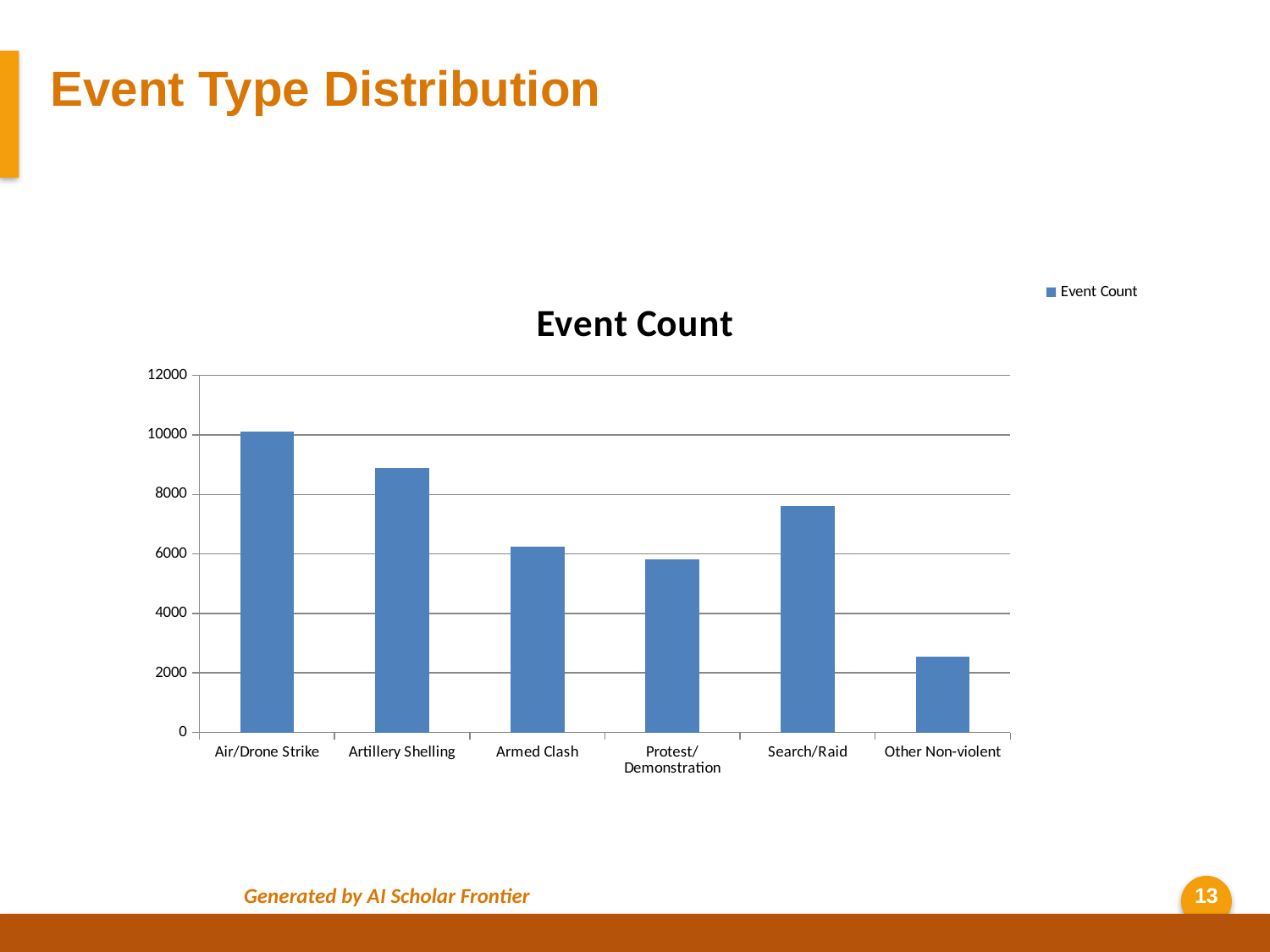
Is the event count for Artillery Shelling greater or less than 8000? greater Which event type has the lowest event count? Other Non-violent Is the event count for Other Non-violent greater or less than 4000? less Which has a larger event count, Protest/Demonstration or Other Non-violent? Protest/Demonstration How many event type categories are shown on the x axis? 6 What is the title of the chart? Event Count How many series does the legend list? 1 Is the event count for Search/Raid greater or less than 8000? less Which has a larger event count, Artillery Shelling or Search/Raid? Artillery Shelling What kind of chart is shown on the slide? bar chart Which event type has the highest event count? Air/Drone Strike